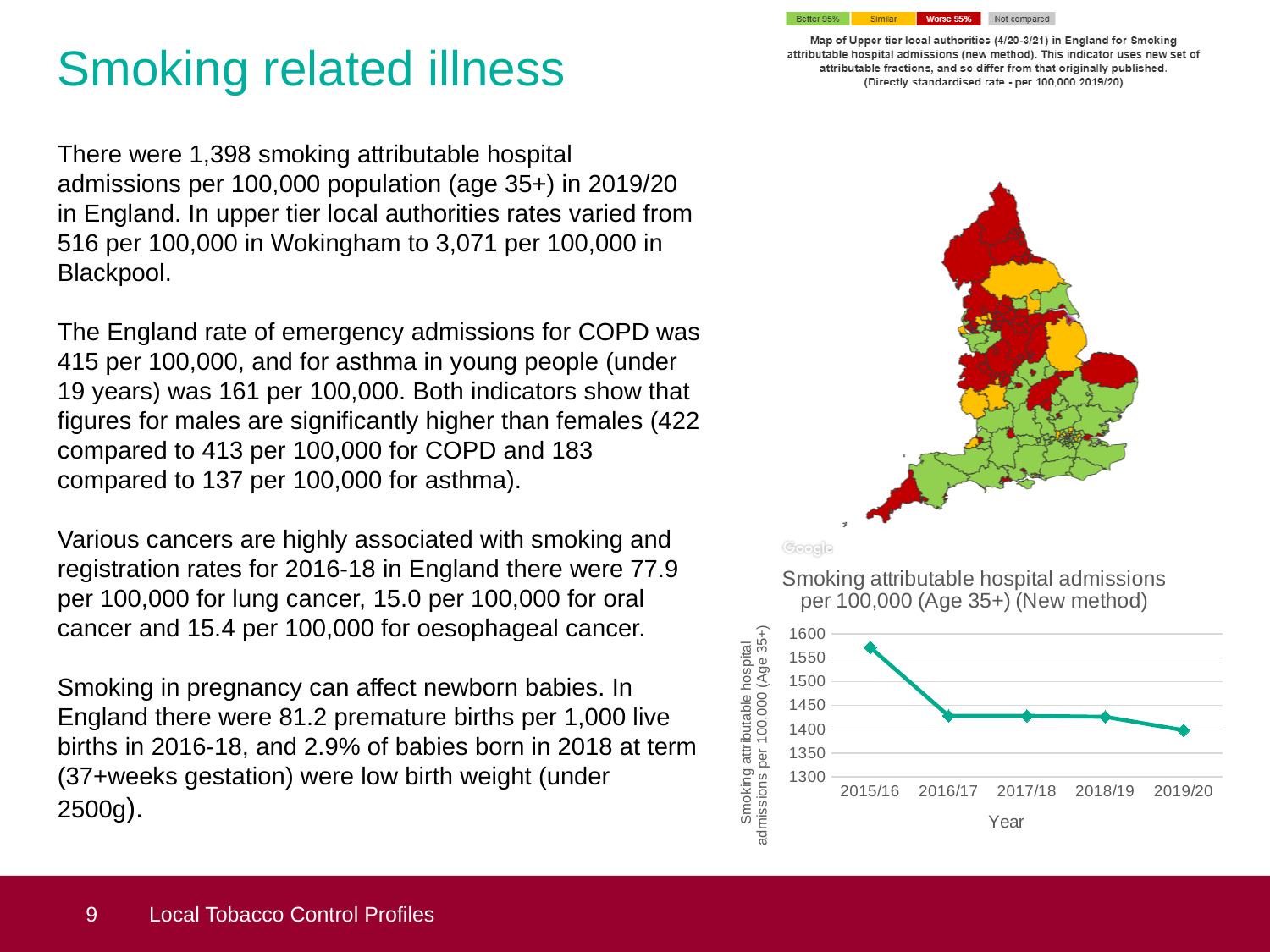
On the 'Smoking attributable hospital admissions' line chart, which year has the larger value, 2015/16 or 2016/17? 2015/16 How many years are plotted on the 'Smoking attributable hospital admissions per 100,000 (Age 35+) (New method)' chart? 5 On the 'Smoking attributable hospital admissions' line chart, which year has the lowest value? 2019/20 On the 'Smoking attributable hospital admissions' line chart, is the value for 2018/19 greater or less than 1350? greater What is the first year shown on the x axis of the 'Smoking attributable hospital admissions' line chart? 2015/16 On the 'Smoking attributable hospital admissions' line chart, is the value for 2015/16 greater or less than 1500? greater On the 'Smoking attributable hospital admissions' line chart, which year has the highest value? 2015/16 What kind of chart is the 'Smoking attributable hospital admissions per 100,000 (Age 35+) (New method)' chart? line chart On the 'Smoking attributable hospital admissions' line chart, is the value for 2016/17 greater or less than 1500? less What is the x-axis title of the 'Smoking attributable hospital admissions' line chart? Year On the 'Smoking attributable hospital admissions' line chart, do the values generally rise or fall from 2015/16 to 2019/20? fall